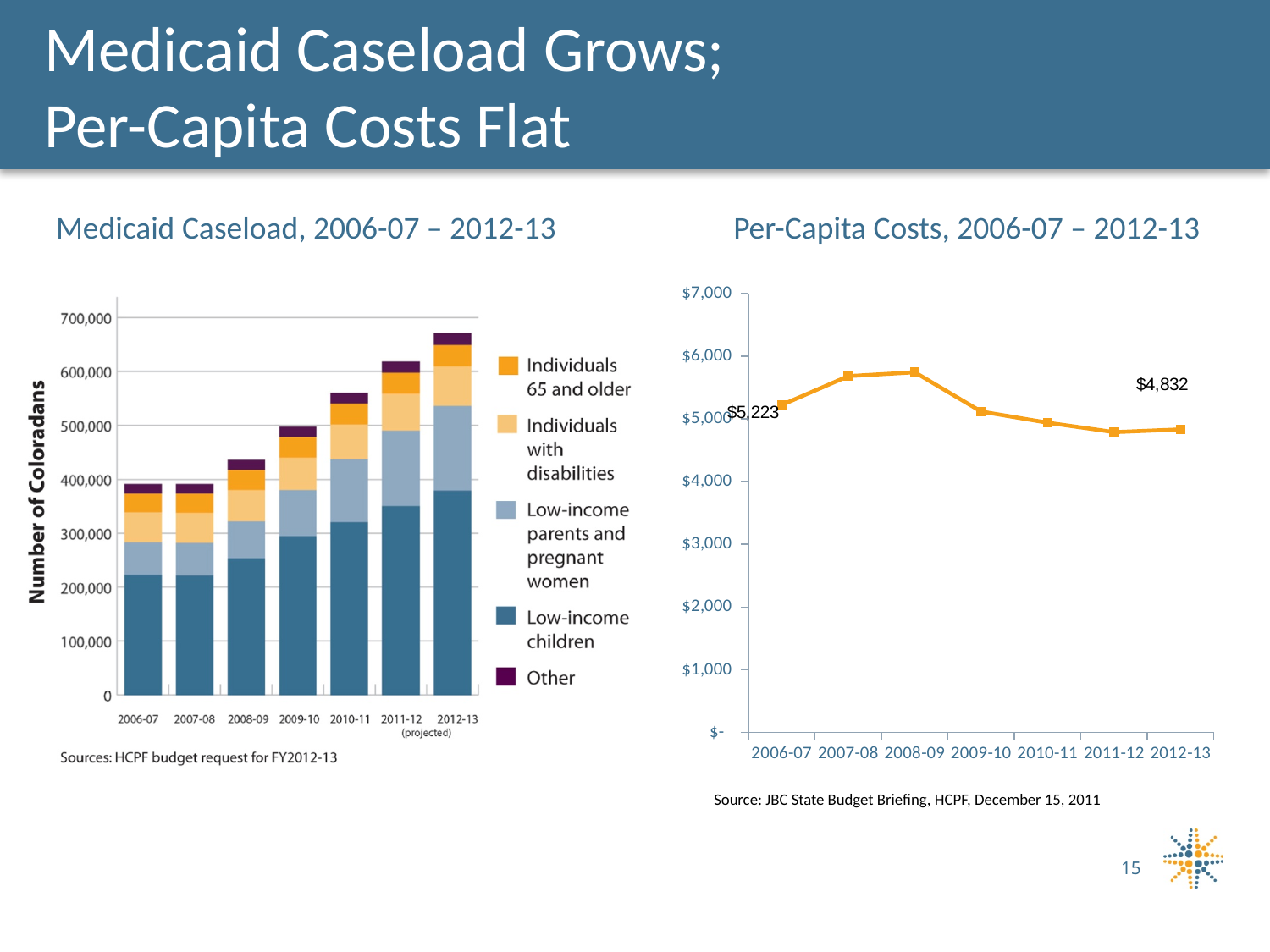
On the Per-Capita Costs chart, which is larger, the value for 2006-07 or the value for 2012-13? 2006-07 On the Medicaid Caseload chart, how many series does the legend list? 5 On the Per-Capita Costs chart, what is the value for 2006-07? $5,223 On the Per-Capita Costs chart, is the value for 2008-09 greater or less than $5,000? greater What kind of chart is the Per-Capita Costs chart? line chart On the Per-Capita Costs chart, is the value for 2011-12 greater or less than $5,000? less On the Per-Capita Costs chart, what is the difference between the 2006-07 value and the 2012-13 value? $391 On the Per-Capita Costs chart, how many data points are plotted? 7 On the Per-Capita Costs chart, what is the value for 2012-13? $4,832 What kind of chart is the Medicaid Caseload chart? stacked bar chart On the Medicaid Caseload chart, which year has the highest total caseload? 2012-13 On the Medicaid Caseload chart, is the total for 2012-13 greater or less than 600,000? greater